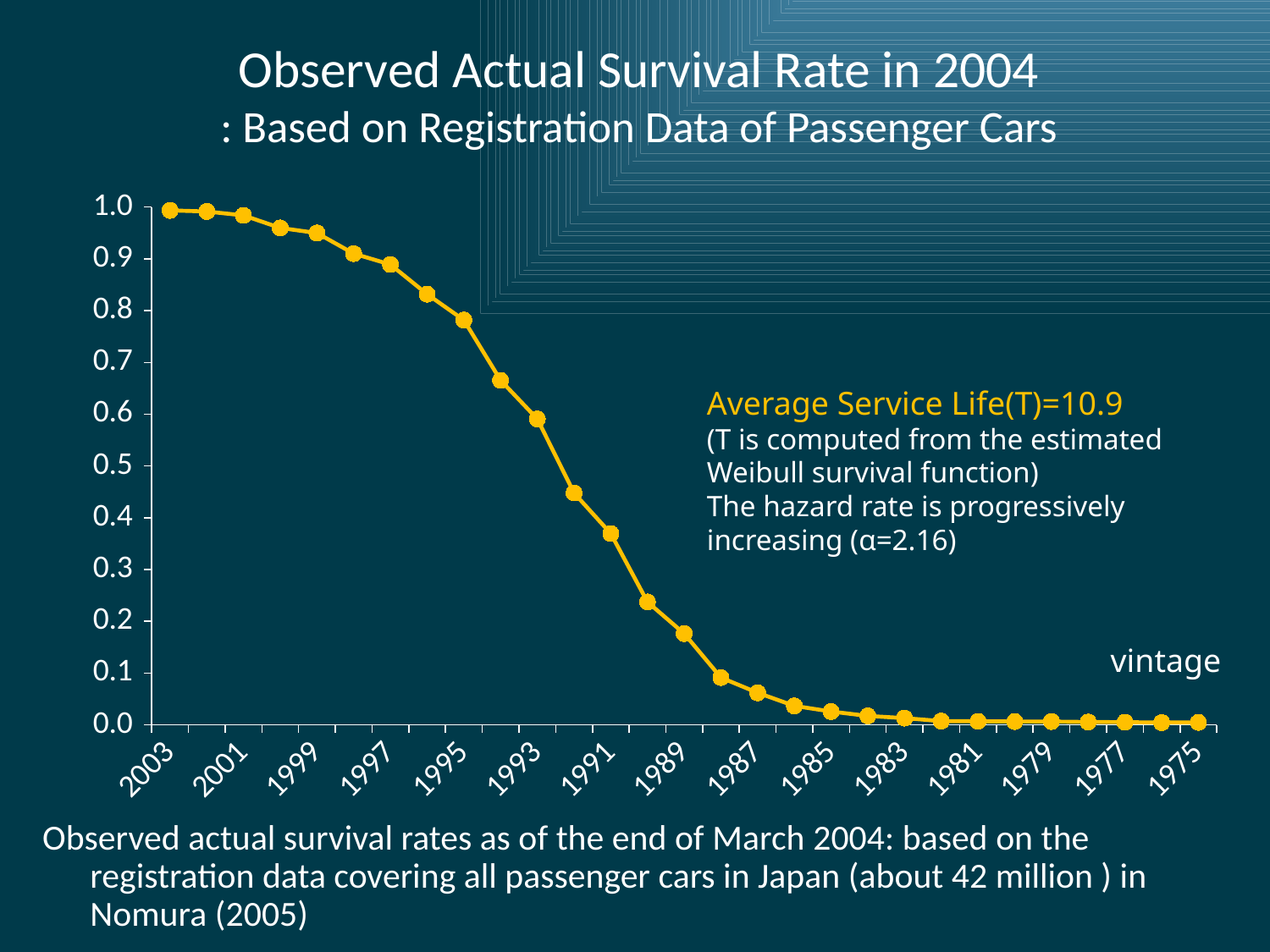
How many vintage years are plotted on the x axis of the chart? 29 Is the survival rate for vintage 1985 greater or less than 0.1? less Is the survival rate for vintage 1991 greater or less than 0.5? less Do the survival rates rise or fall as the x axis moves from 2003 toward 1975? fall Which has a higher survival rate, vintage 1993 or vintage 1989? 1993 Which vintage year has the highest survival rate in the chart? 2003 What kind of chart is shown on the slide? line chart Is the survival rate for vintage 1989 greater or less than 0.2? less What average service life (T) is stated on the chart? 10.9